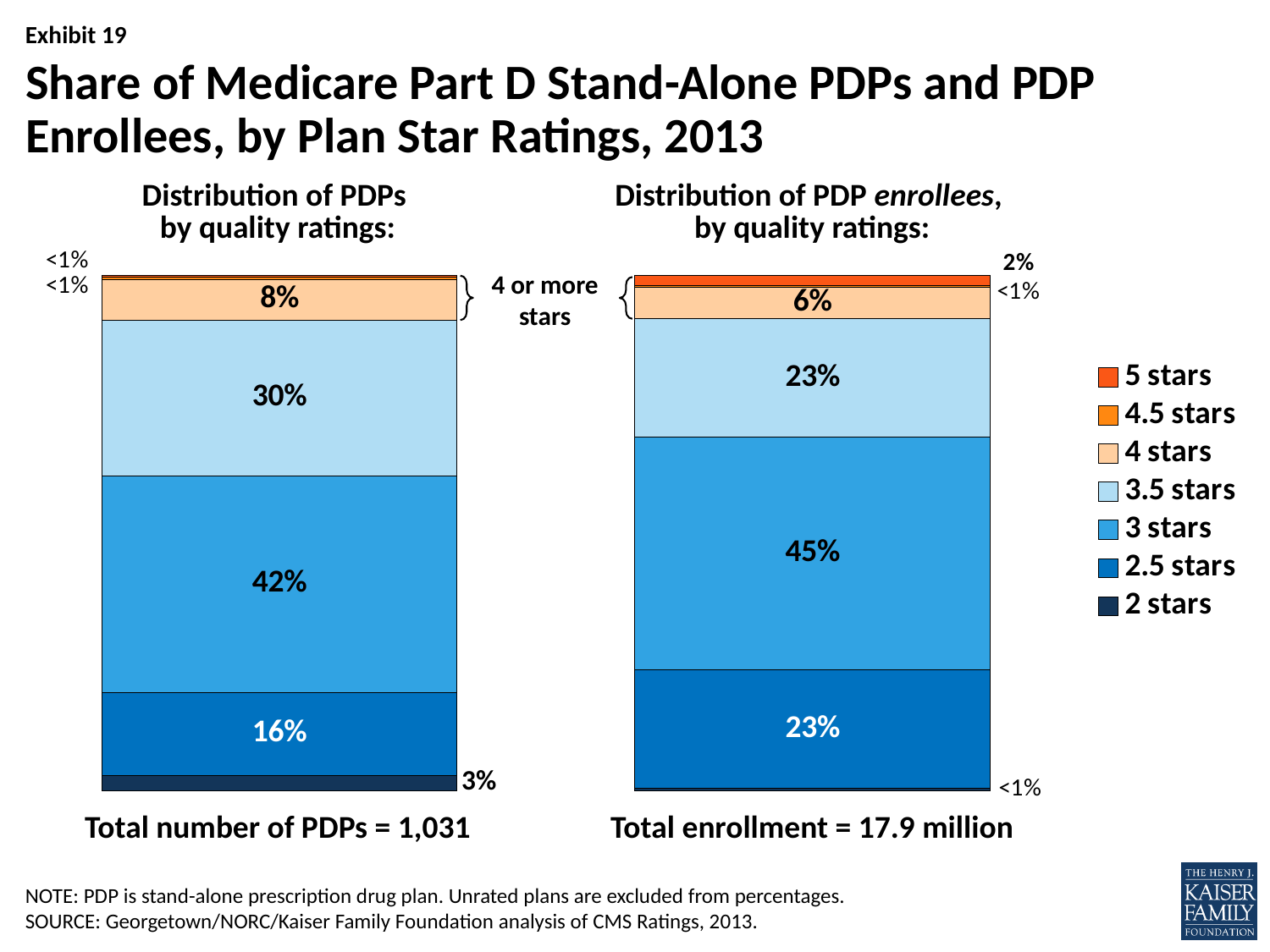
What kind of chart is used to show the distribution of PDPs by quality ratings? Stacked bar chart In the 'Distribution of PDPs by quality ratings' chart, what share of PDPs have a 3 stars rating? 42% In the 'Distribution of PDP enrollees by quality ratings' chart, what share of enrollees are in 3 stars plans? 45% In the 'Distribution of PDP enrollees by quality ratings' chart, which star rating has the largest share of enrollees? 3 stars In the 'Distribution of PDPs by quality ratings' chart, what share of PDPs have a 2 stars rating? 3% Is the 3.5 stars share larger in the 'Distribution of PDPs' chart or in the 'Distribution of PDP enrollees' chart? Distribution of PDPs How many star-rating categories does the legend list? 7 In the 'Distribution of PDP enrollees by quality ratings' chart, what share of enrollees are in 5 stars plans? 2% In the 'Distribution of PDPs by quality ratings' chart, what share of PDPs have a 4 stars rating? 8% In the 'Distribution of PDPs by quality ratings' chart, how many percentage points larger is the 3 stars share than the 2.5 stars share? 26 percentage points In the 'Distribution of PDPs by quality ratings' chart, which star rating accounts for the largest share of PDPs? 3 stars In the 'Distribution of PDP enrollees by quality ratings' chart, how many percentage points larger is the 3 stars share than the 3.5 stars share? 22 percentage points